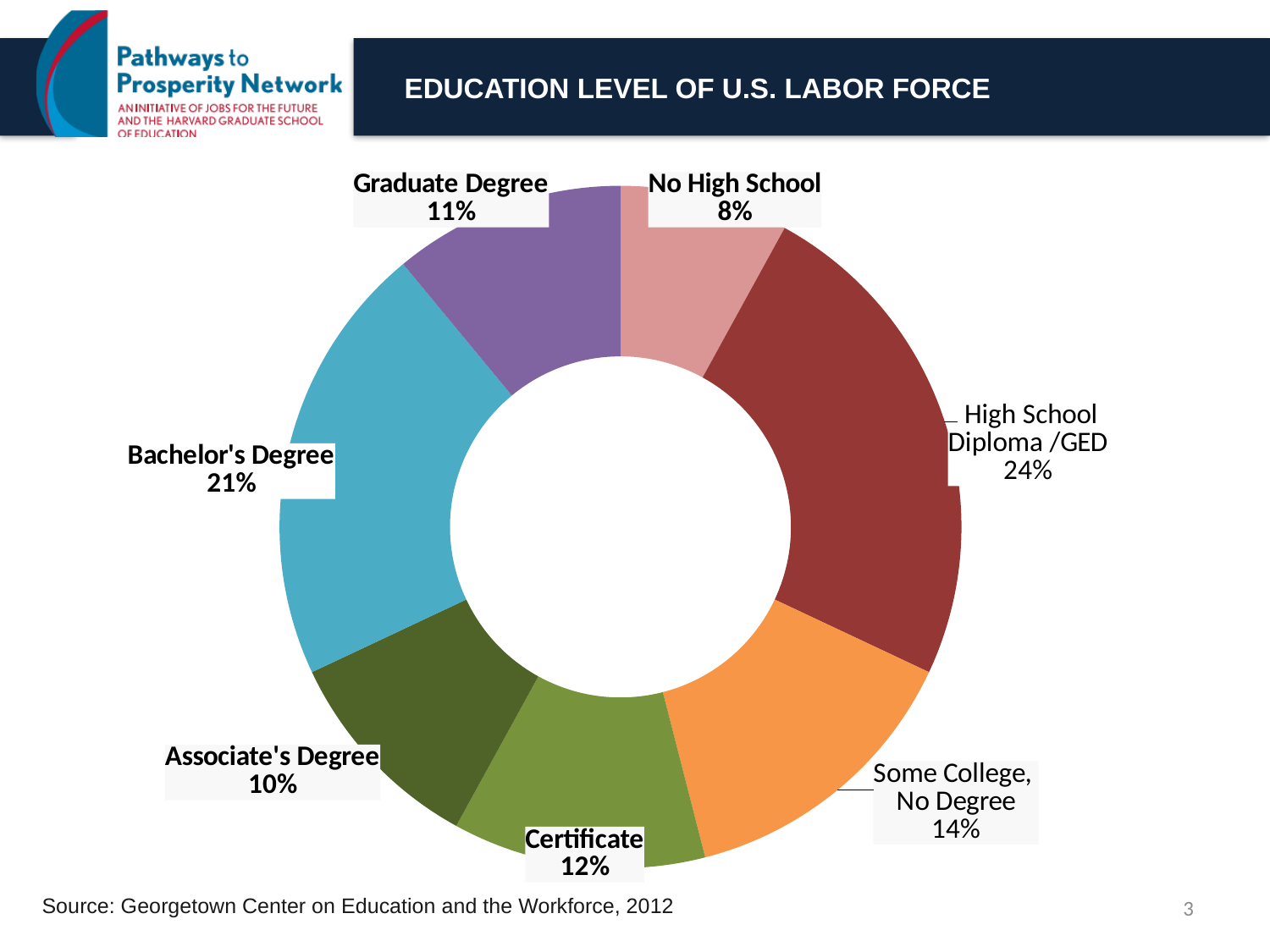
Which is larger, the share for Some College, No Degree or the share for Graduate Degree? Some College, No Degree How many education level categories are shown in the chart? 7 Which education level has the largest share of the labor force? High School Diploma /GED What is the difference between the shares for Bachelor's Degree and Associate's Degree? 11% What is the combined share of Bachelor's Degree and Graduate Degree? 32% What is the title of the chart? EDUCATION LEVEL OF U.S. LABOR FORCE What kind of chart is shown on the slide? Pie chart (doughnut) What is the value shown for Certificate? 12% What percentage of the labor force has a Bachelor's Degree? 21% What is the source cited for the chart data? Georgetown Center on Education and the Workforce, 2012 What share of the U.S. labor force has a High School Diploma/GED? 24% Which education level has the smallest share of the labor force? No High School